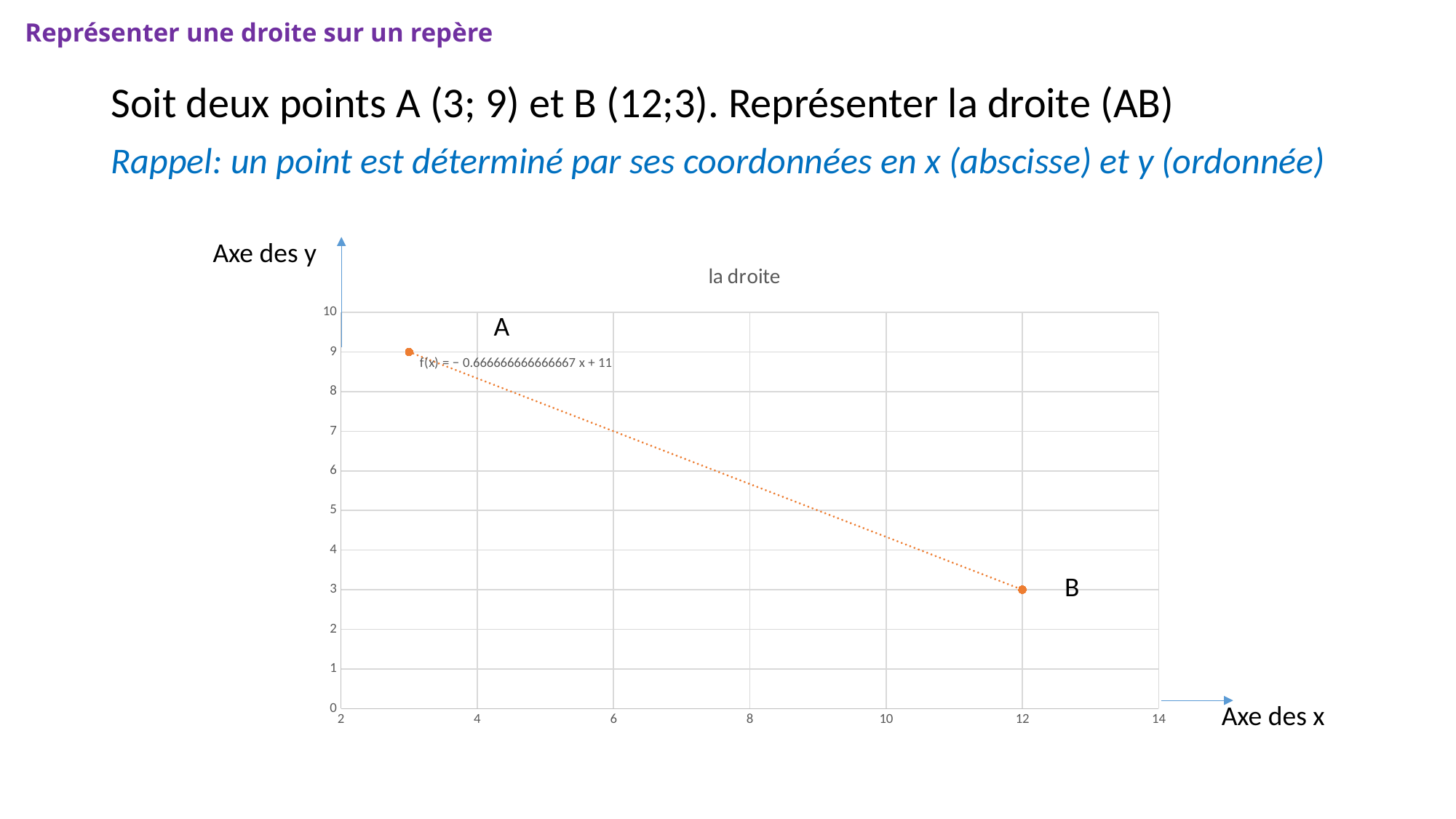
What is the y value of point B? 3 What is the y value of point A? 9 What is the title of the chart? la droite What equation is printed next to the line on the chart? f(x) = − 0.666666666666667 x + 11 Which point has the higher y value, A or B? A How many points are plotted on the chart? 2 What kind of chart is shown on the slide? scatter chart Is the y value of point B greater or less than 5? less Does the line rise or fall as x increases? falls Which point has the lowest y value? B What is the x value of point B? 12 What is the difference between the y values of point A and point B? 6